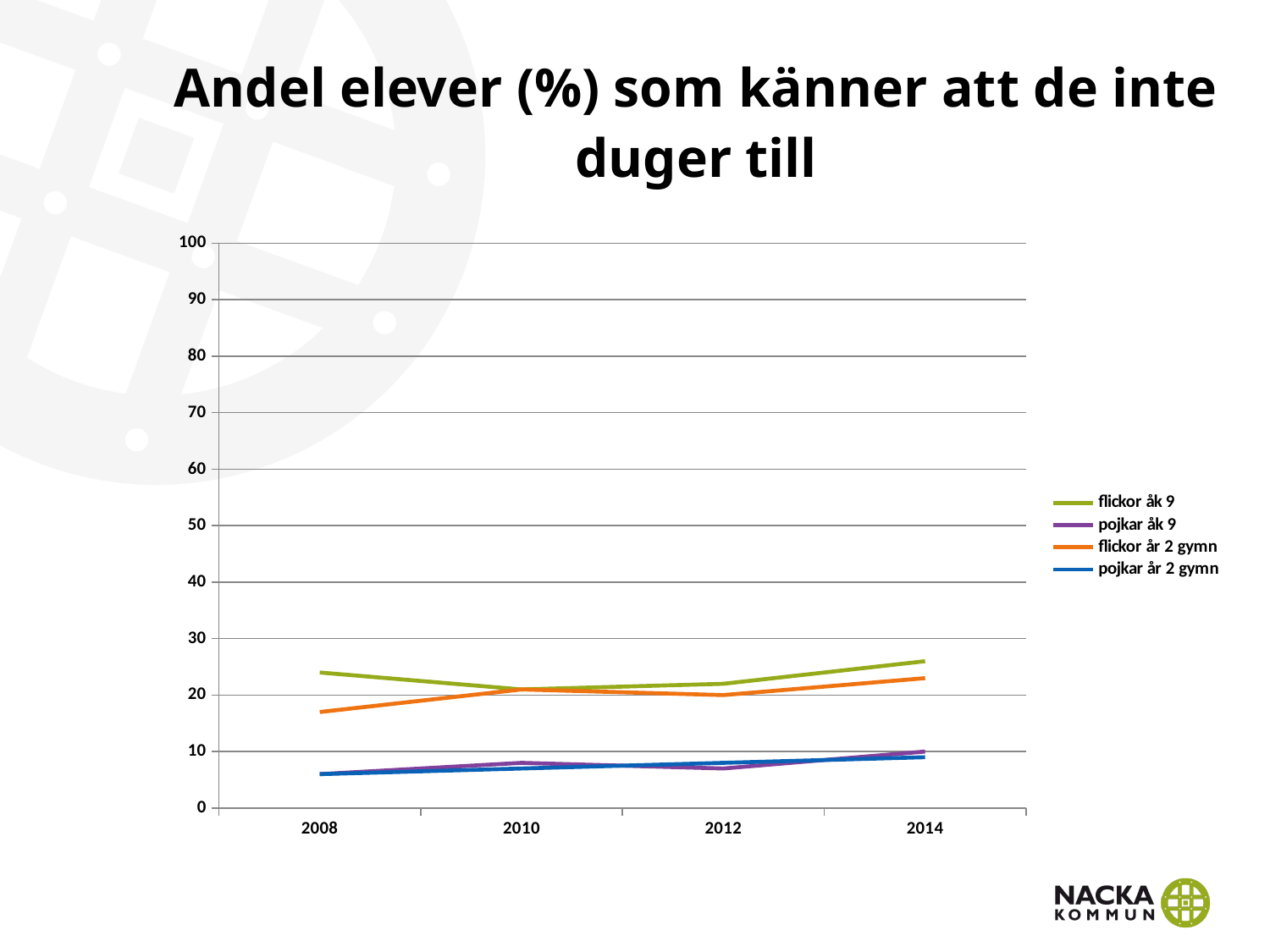
Which series is drawn in orange according to the legend? flickor år 2 gymn Is the value for flickor åk 9 in 2014 greater or less than 30? less What is the title of the chart? Andel elever (%) som känner att de inte duger till Is the value for pojkar åk 9 in 2008 greater or less than 10? less Is the value for flickor åk 9 in 2008 greater or less than 20? greater Which series has the highest value in 2008? flickor åk 9 How many series does the legend list? 4 Does the value for flickor åk 9 rise or fall from 2012 to 2014? rise What kind of chart is shown on the slide? line chart Which is larger in 2014, flickor åk 9 or flickor år 2 gymn? flickor åk 9 How many years are shown on the x axis? 4